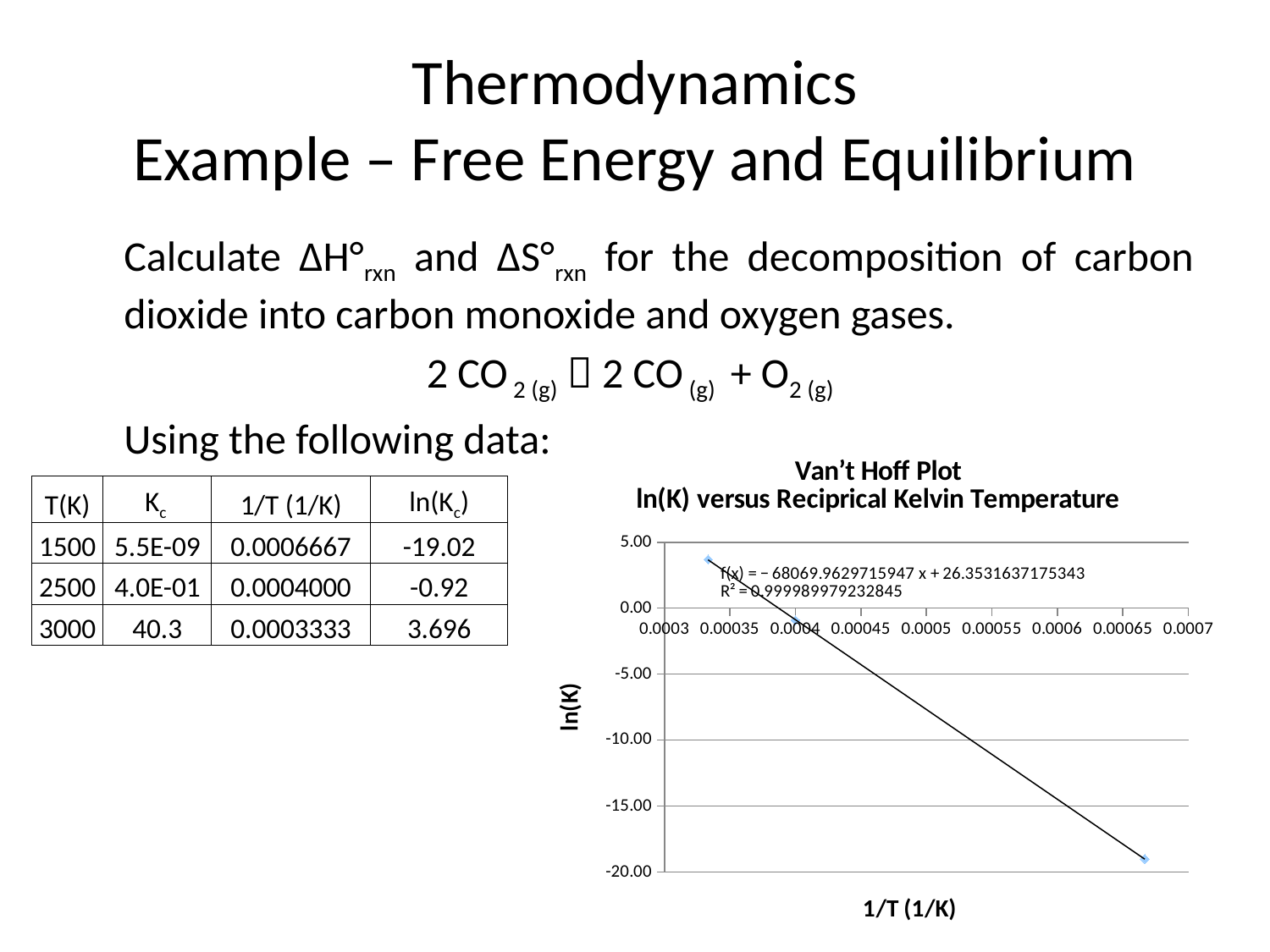
On the Van't Hoff Plot, is the ln(K) value at 1/T = 0.0006667 greater or less than -15? less On the Van't Hoff Plot, is the ln(K) value at 1/T = 0.0004000 greater or less than -5? greater Which temperature in the data table has the lowest ln(Kc)? 1500 According to the data table on the slide, what is ln(Kc) at T = 3000 K? 3.696 What kind of chart is the Van't Hoff Plot on the slide? scatter plot How many data points are plotted on the Van't Hoff Plot? 3 On the Van't Hoff Plot, is the ln(K) value at 1/T = 0.0003333 greater or less than 0? greater Which temperature in the data table has the highest ln(Kc)? 3000 What is the label of the x axis on the Van't Hoff Plot? 1/T (1/K) On the Van't Hoff Plot, does ln(K) rise or fall as 1/T increases? fall According to the data table on the slide, what is ln(Kc) at T = 1500 K? -19.02 What is the label of the y axis on the Van't Hoff Plot? ln(K)